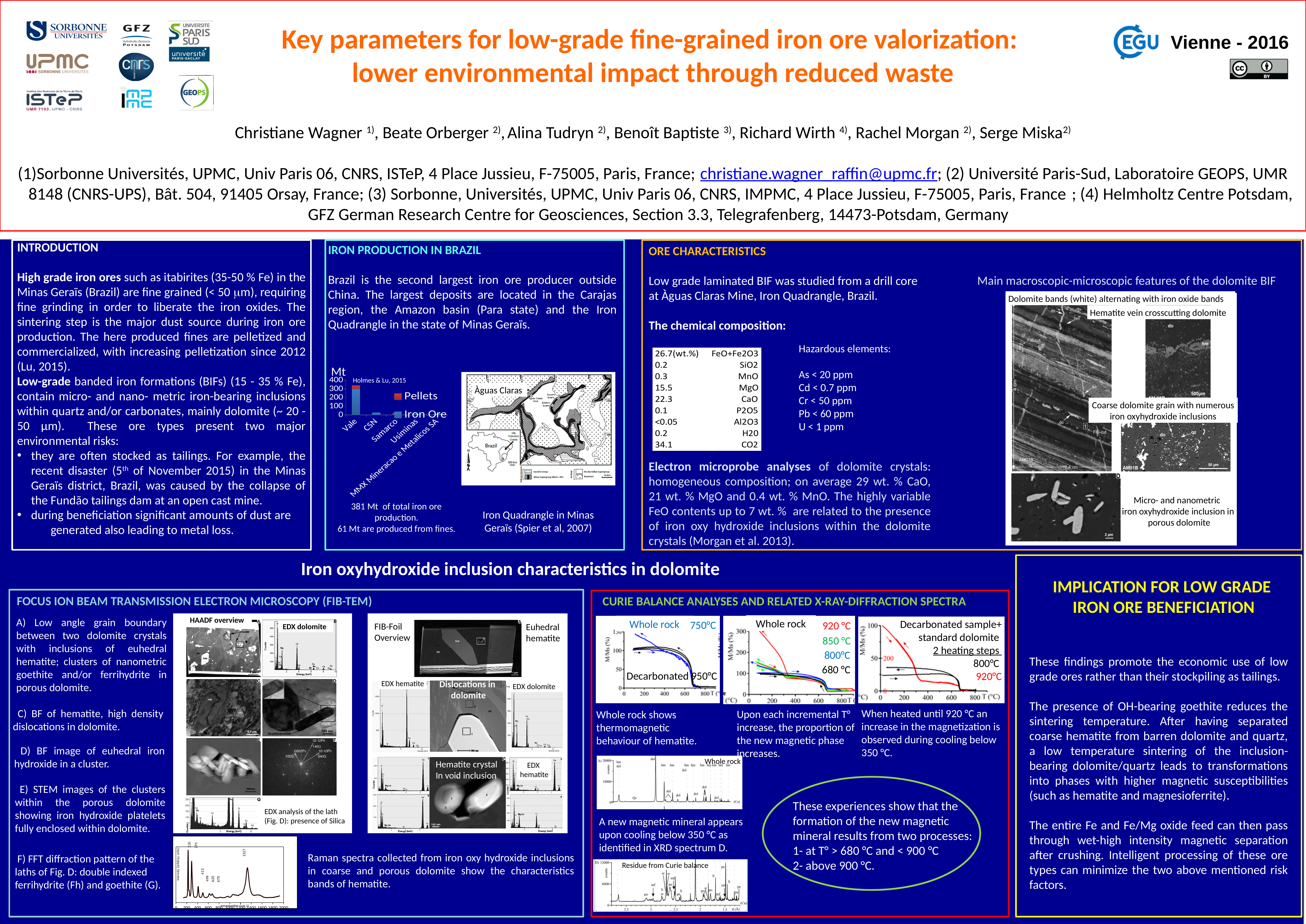
In the iron production bar chart, which is larger, the bar for Vale or the bar for CSN? Vale In the iron production bar chart, is the value for CSN greater or less than 100? less What kind of chart is shown in the 'IRON PRODUCTION IN BRAZIL' section? bar chart In the iron production bar chart, is the value for Samarco greater or less than 100? less In the iron production bar chart, is the value for Vale greater or less than 200? greater Which company has the highest bar in the iron production bar chart? Vale What unit is shown on the y axis of the iron production bar chart? Mt What are the two legend entries of the iron production bar chart? Pellets, Iron Ore How many companies (categories) are shown on the x axis of the iron production bar chart? 5 How many series does the legend of the iron production bar chart list? 2